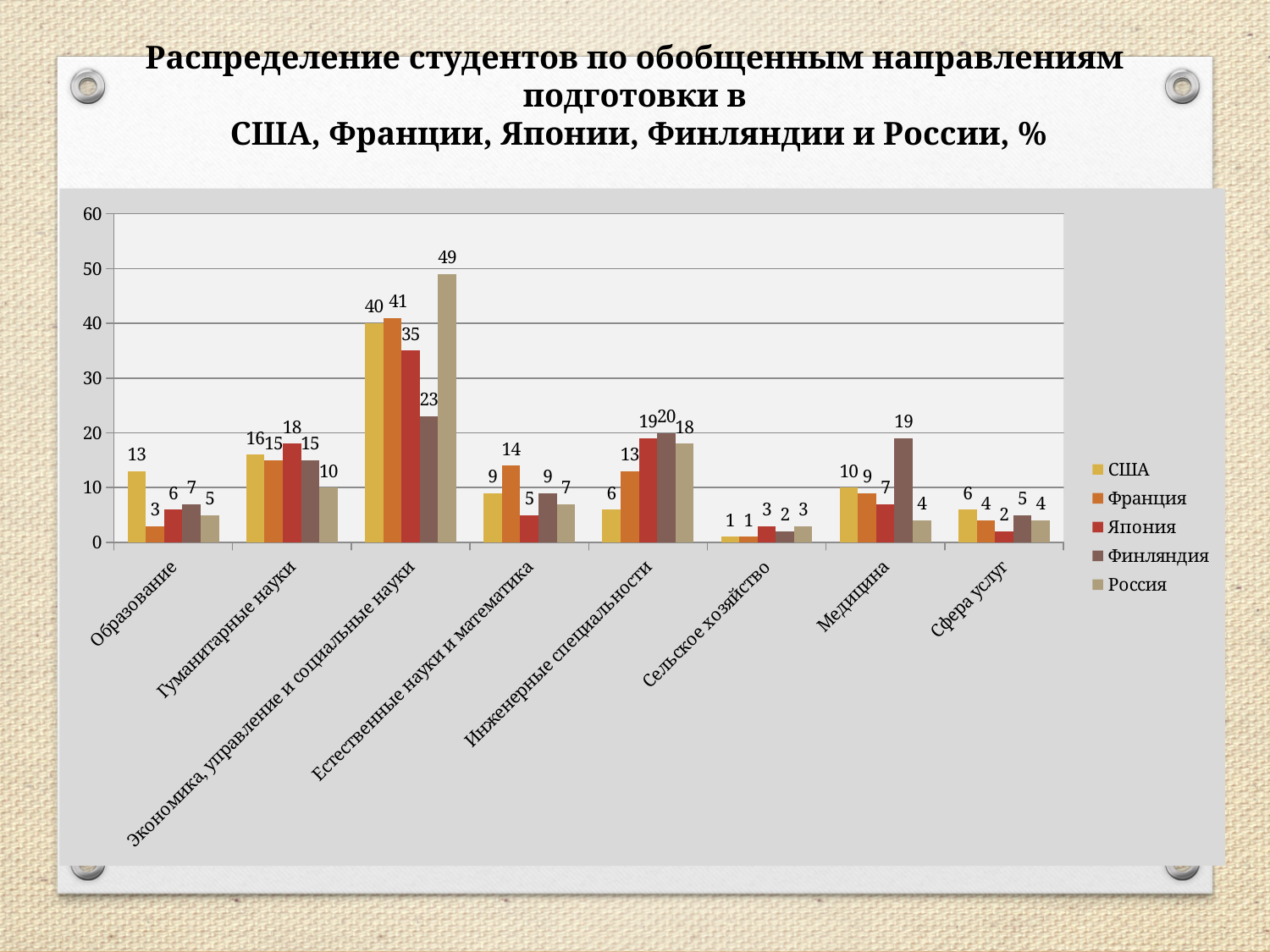
Which is larger in the Образование category: the value for США or the value for Франция? США What is the value for Россия in the Экономика, управление и социальные науки category? 49 How many categories are shown on the x axis? 8 Which country has the lowest value in the Медицина category? Россия What is the difference between the Финляндия and Россия values in the Медицина category? 15 How many series does the legend list? 5 What kind of chart is shown on the slide? Bar chart Which series is shown in yellow in the legend? США What is the value for Финляндия in the Медицина category? 19 Which country has the highest value in the Экономика, управление и социальные науки category? Россия What is the value for Япония in the Инженерные специальности category? 19 What is the value for США in the Образование category? 13